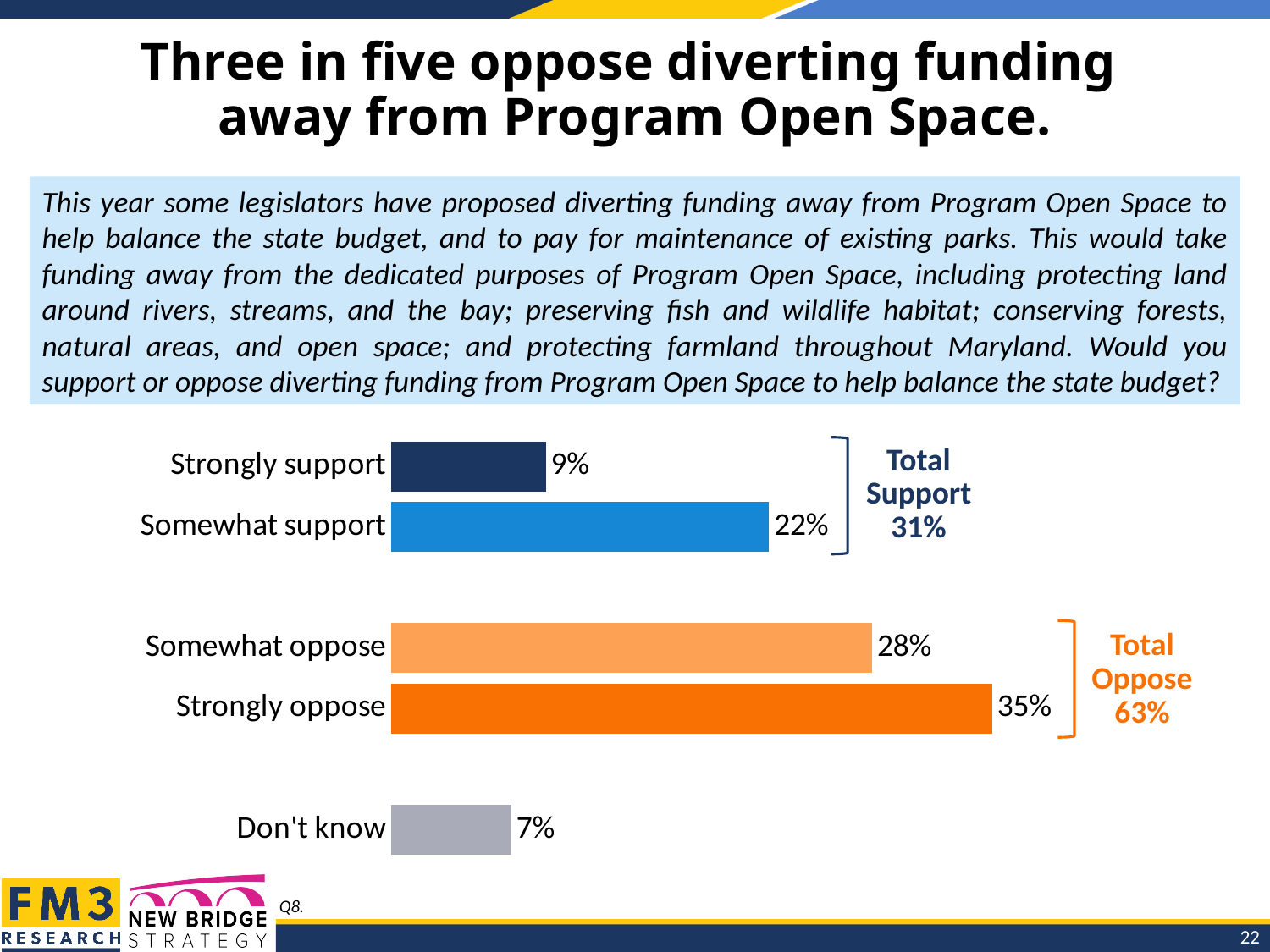
What percentage of respondents answered 'Don't know'? 7% What is the Total Support percentage shown on the chart? 31% What percentage of respondents strongly support diverting funding from Program Open Space? 9% Which response category has the lowest percentage? Don't know What percentage of respondents somewhat oppose diverting funding from Program Open Space? 28% What is the difference in percentage points between 'Strongly oppose' and 'Strongly support'? 26 Which response category has the highest percentage? Strongly oppose Which is larger, the percentage for 'Somewhat support' or for 'Somewhat oppose'? Somewhat oppose What colour is the 'Don't know' bar? Gray What is the Total Oppose percentage shown on the chart? 63% What type of chart is shown on the slide? Bar chart How many response categories are shown in the chart? 5